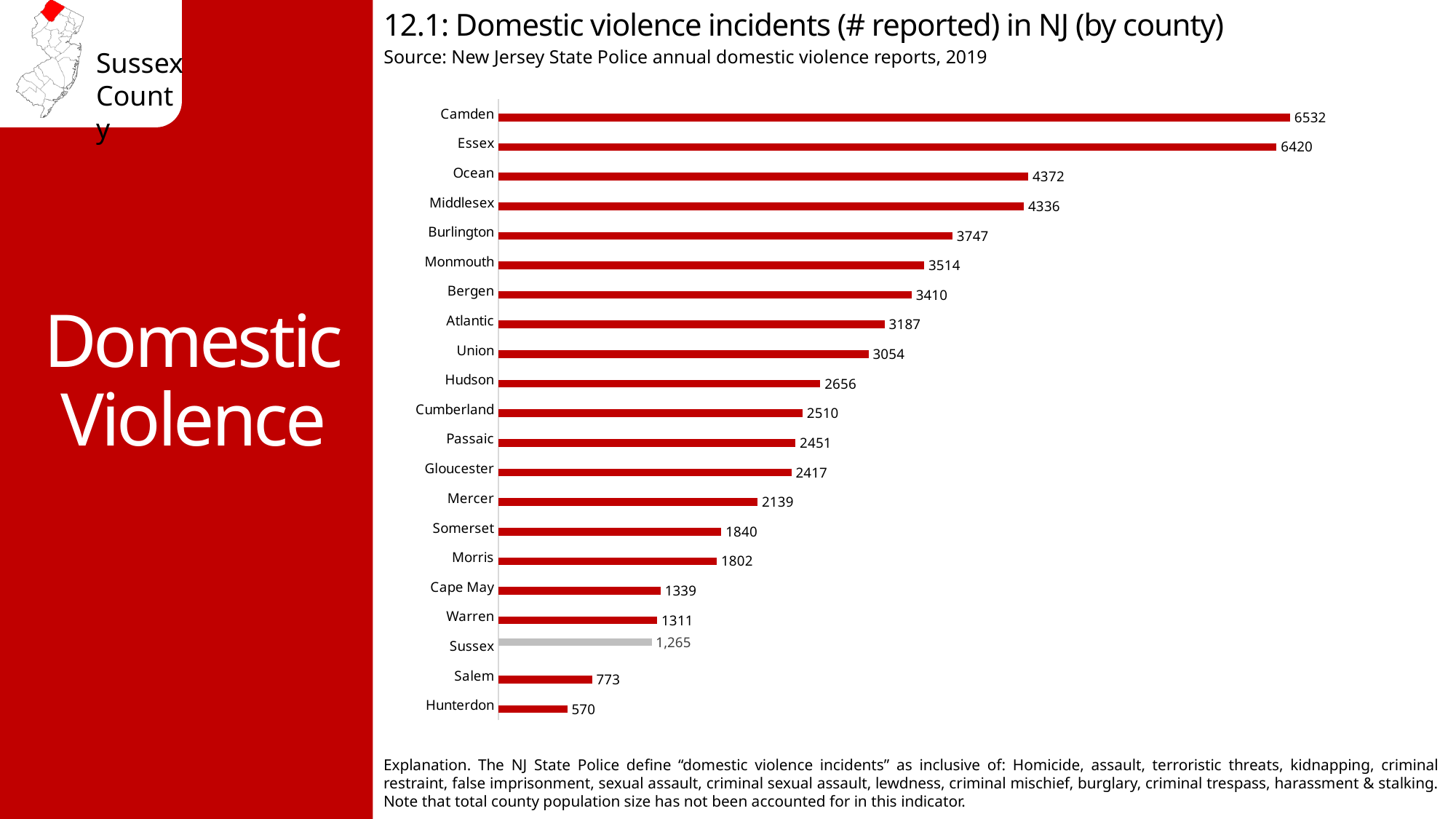
How many counties are shown in the chart? 21 Which county has more reported incidents, Warren or Sussex? Warren What is the difference between the values for Salem and Hunterdon? 203 How many incidents were reported in Morris county? 1802 What is the difference between the values for Camden and Essex? 112 Which county has the highest number of reported domestic violence incidents? Camden How many domestic violence incidents were reported in Camden county? 6532 What kind of chart is shown on the slide? Bar chart What is the value shown for Sussex county? 1,265 Which county has more reported incidents, Bergen or Atlantic? Bergen Which county has the lowest number of reported domestic violence incidents? Hunterdon Which county's bar is coloured grey instead of red? Sussex